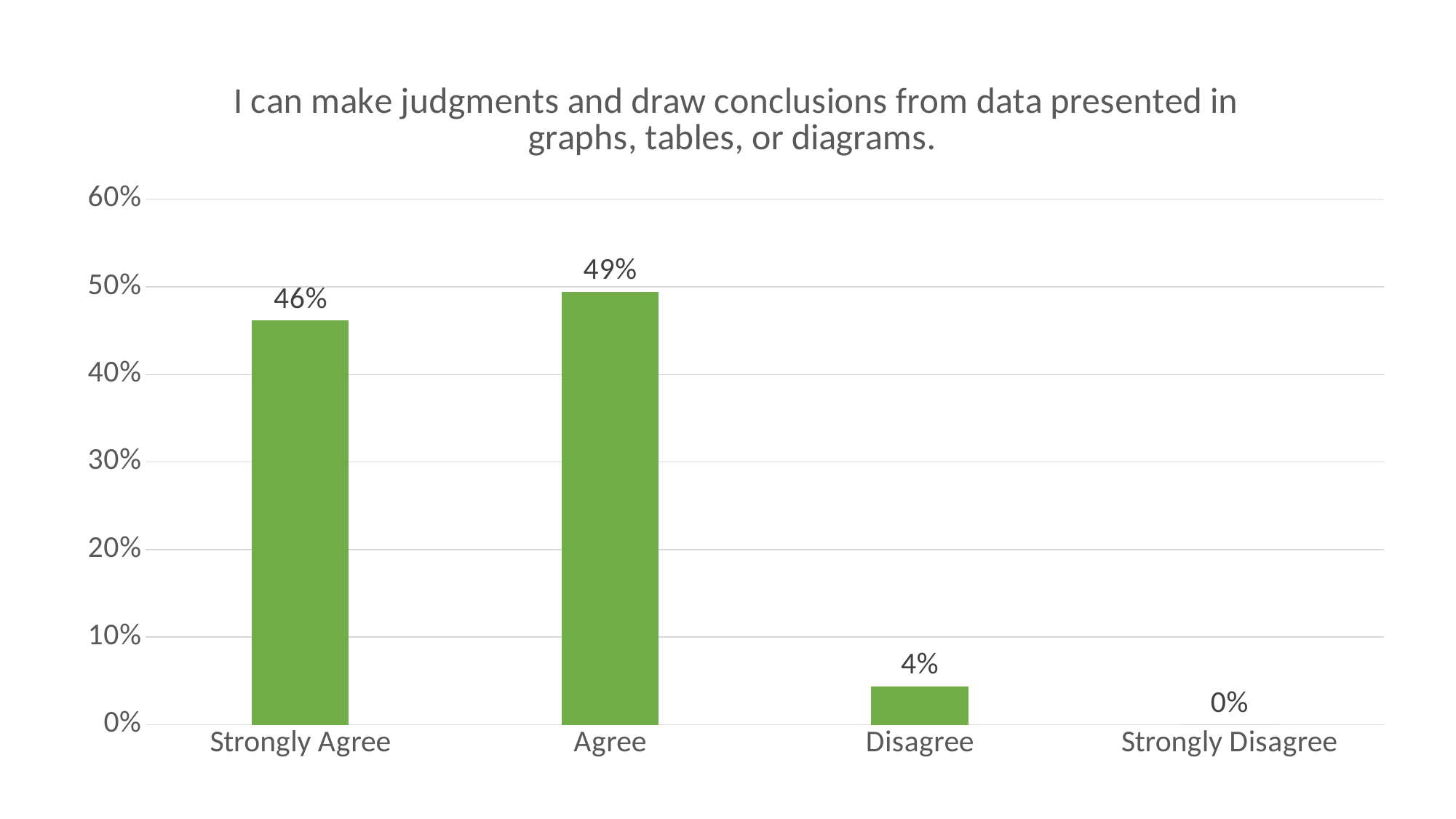
Which category has the lowest value? Strongly Disagree What is the value for Strongly Agree? 46% What is the value for Strongly Disagree? 0% Which category has the highest value? Agree Is the value for Agree greater or less than 40%? greater What is the difference between the values for Agree and Strongly Agree? 3% Which is larger, the value for Strongly Agree or the value for Disagree? Strongly Agree What is the title of the chart? I can make judgments and draw conclusions from data presented in graphs, tables, or diagrams. How many categories are shown on the x axis? 4 What is the value for Agree? 49% What is the value for Disagree? 4% What kind of chart is shown on the slide? bar chart